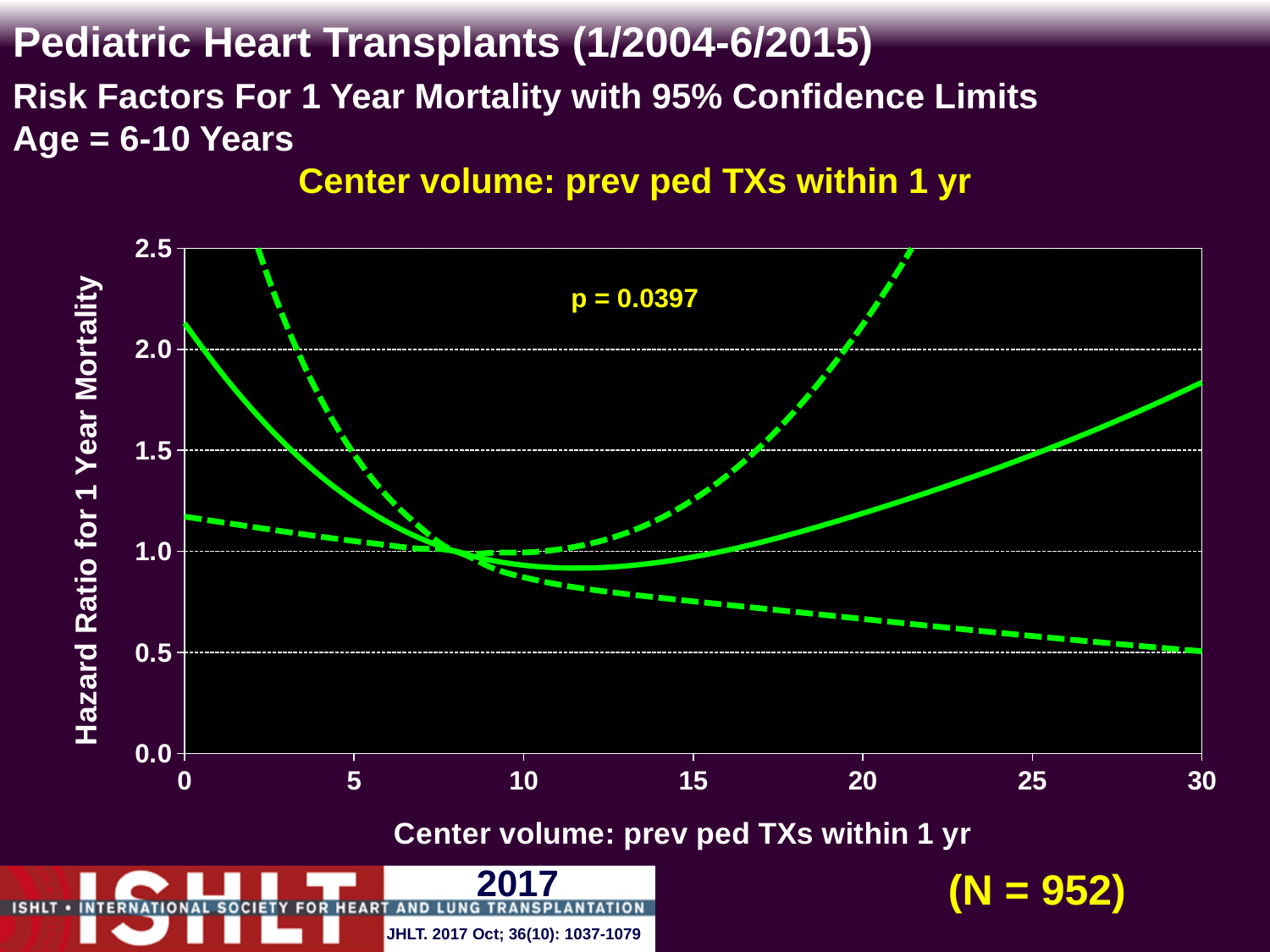
Is the value of the lower dashed confidence limit at a center volume of 0 greater or less than 1.0? greater What is the p-value printed on the chart? p = 0.0397 What is the label of the y axis? Hazard Ratio for 1 Year Mortality Does the lower dashed confidence limit rise or fall as center volume increases from 0 to 30? fall What kind of chart is shown on the slide? line chart How many lines are plotted on the chart? 3 Is the value of the solid hazard ratio line at a center volume of 30 greater or less than 1.5? greater Does the solid hazard ratio line rise or fall as center volume increases from 0 to 10? fall Is the value of the lower dashed confidence limit at a center volume of 20 greater or less than 1.0? less Does the solid hazard ratio line rise or fall as center volume increases from 15 to 30? rise